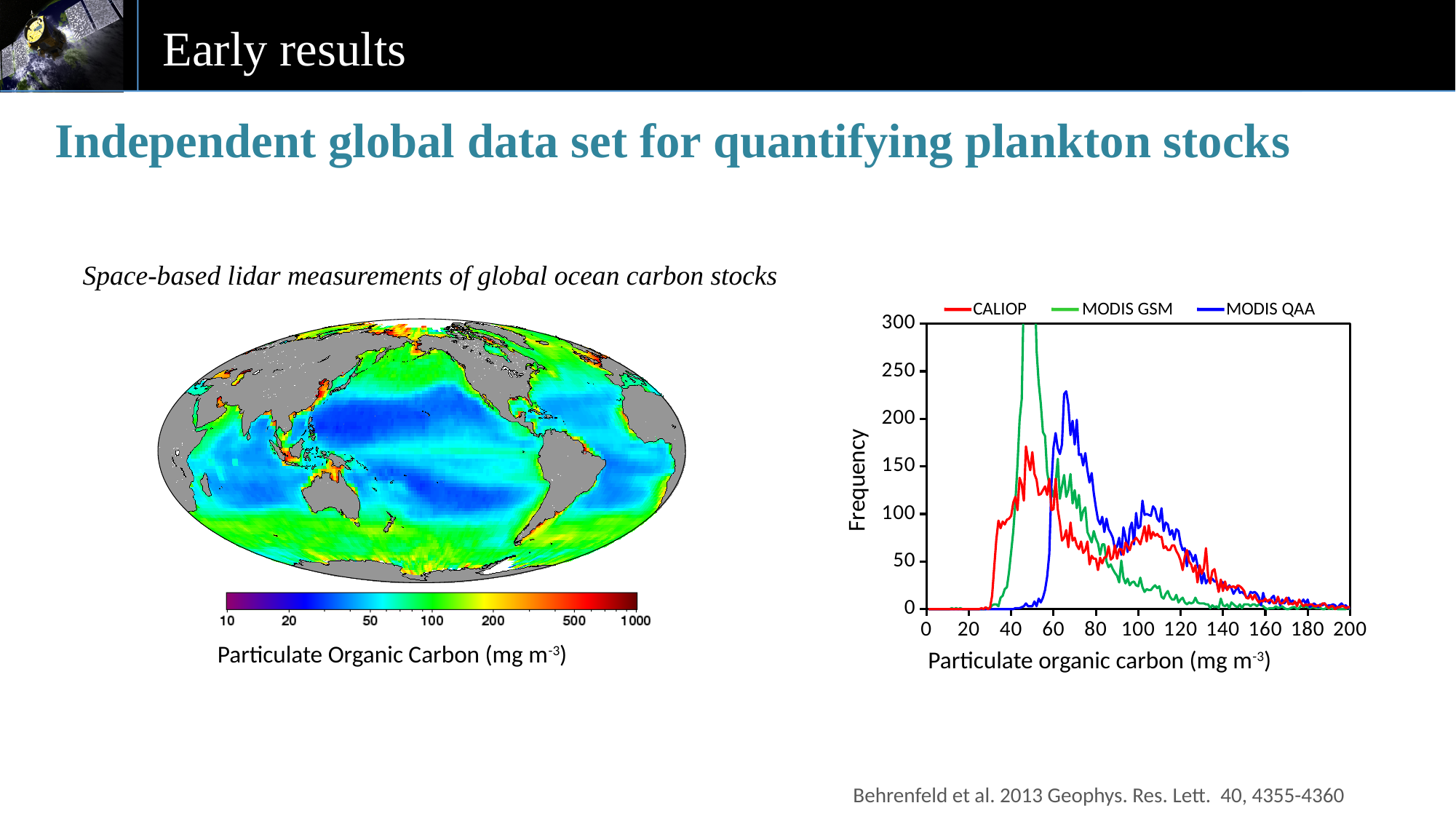
In the frequency chart, is the MODIS GSM frequency at 100 mg m-3 greater or less than 50? less In the frequency chart, is the MODIS QAA frequency at 120 mg m-3 greater or less than 100? less What is the y-axis label of the frequency chart? Frequency Which series in the frequency chart is drawn in red? CALIOP What kind of chart is the chart on the right of the slide? line chart How many series does the legend of the frequency chart list? 3 What is the maximum value shown on the y axis of the frequency chart? 300 In the frequency chart, is the peak frequency of CALIOP greater or less than 200? less In the frequency chart, which series has the higher peak frequency, CALIOP or MODIS QAA? MODIS QAA In the frequency chart, which series reaches the highest peak frequency? MODIS GSM